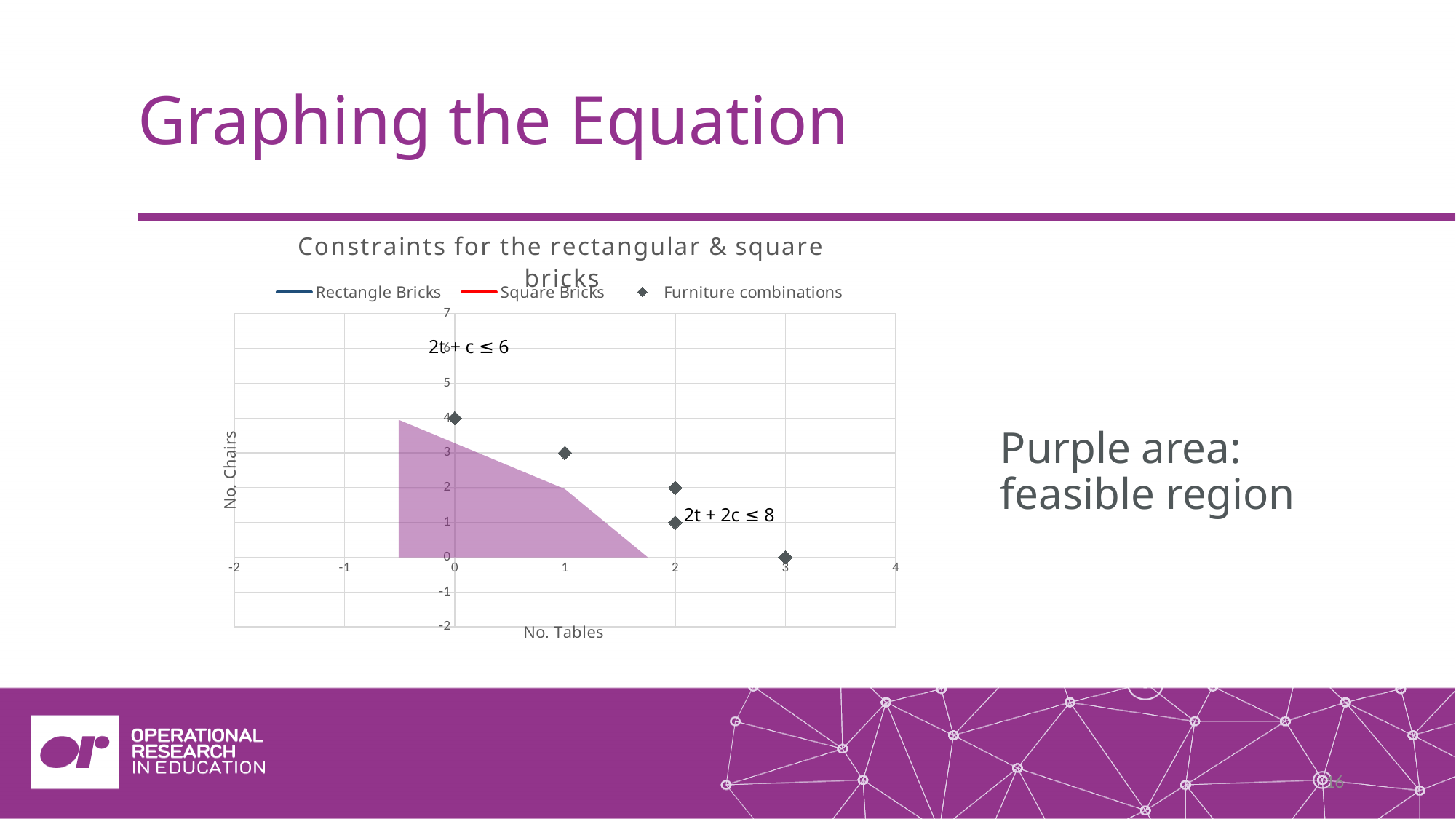
Which Furniture combinations point has the lowest No. Chairs value? The point at 3 tables (0 chairs) What is the label of the x axis of the chart? No. Tables What kind of chart is shown on the slide? Scatter chart How many Furniture combinations points are plotted on the chart? 5 What is the No. Chairs value of the Furniture combinations point at 0 tables? 4 What is the title of the chart? Constraints for the rectangular & square bricks What is the No. Chairs value of the Furniture combinations point at 1 table? 3 How many series does the chart legend list? 3 What is the No. Chairs value of the Furniture combinations point at 3 tables? 0 What is the difference in No. Chairs between the Furniture combinations point at 0 tables and the point at 1 table? 1 Which Furniture combinations point has the highest No. Chairs value? The point at 0 tables (4 chairs) Do the No. Chairs values of the Furniture combinations points rise or fall as No. Tables increases? Fall